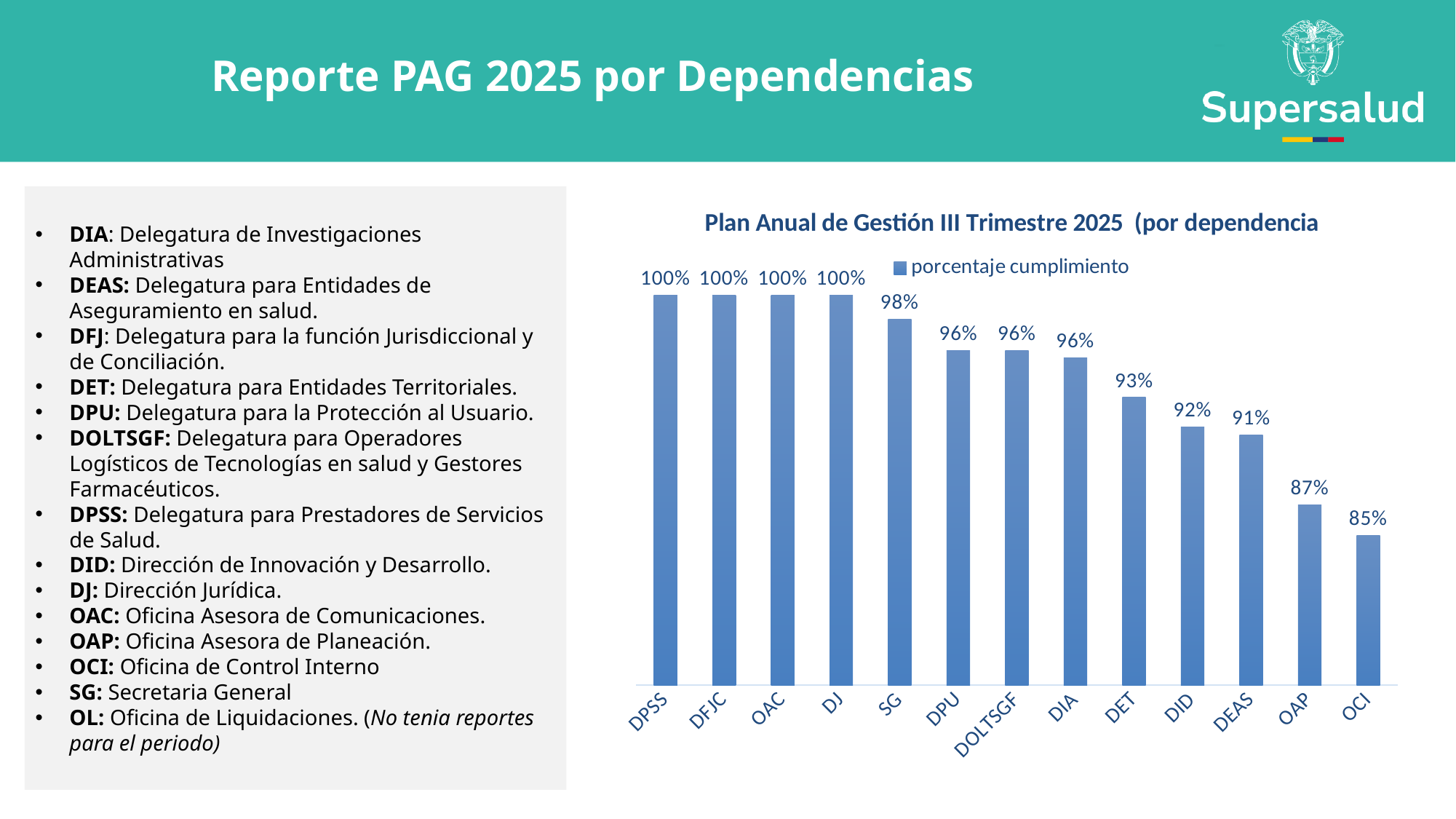
What is the difference between the porcentaje cumplimiento for DID and OAP? 5% What is the porcentaje cumplimiento for DEAS? 91% What is the difference between the porcentaje cumplimiento for DPSS and OCI? 15% How many series does the legend list? 1 What is the porcentaje cumplimiento for OAP? 87% Which dependencia has the lowest porcentaje cumplimiento? OCI Which has a higher porcentaje cumplimiento, DIA or DID? DIA Do the values rise or fall from left to right along the x axis? Fall What kind of chart is shown on the slide? Bar chart How many dependencias are shown in the chart? 13 What is the porcentaje cumplimiento for DET? 93% What is the porcentaje cumplimiento for SG? 98%